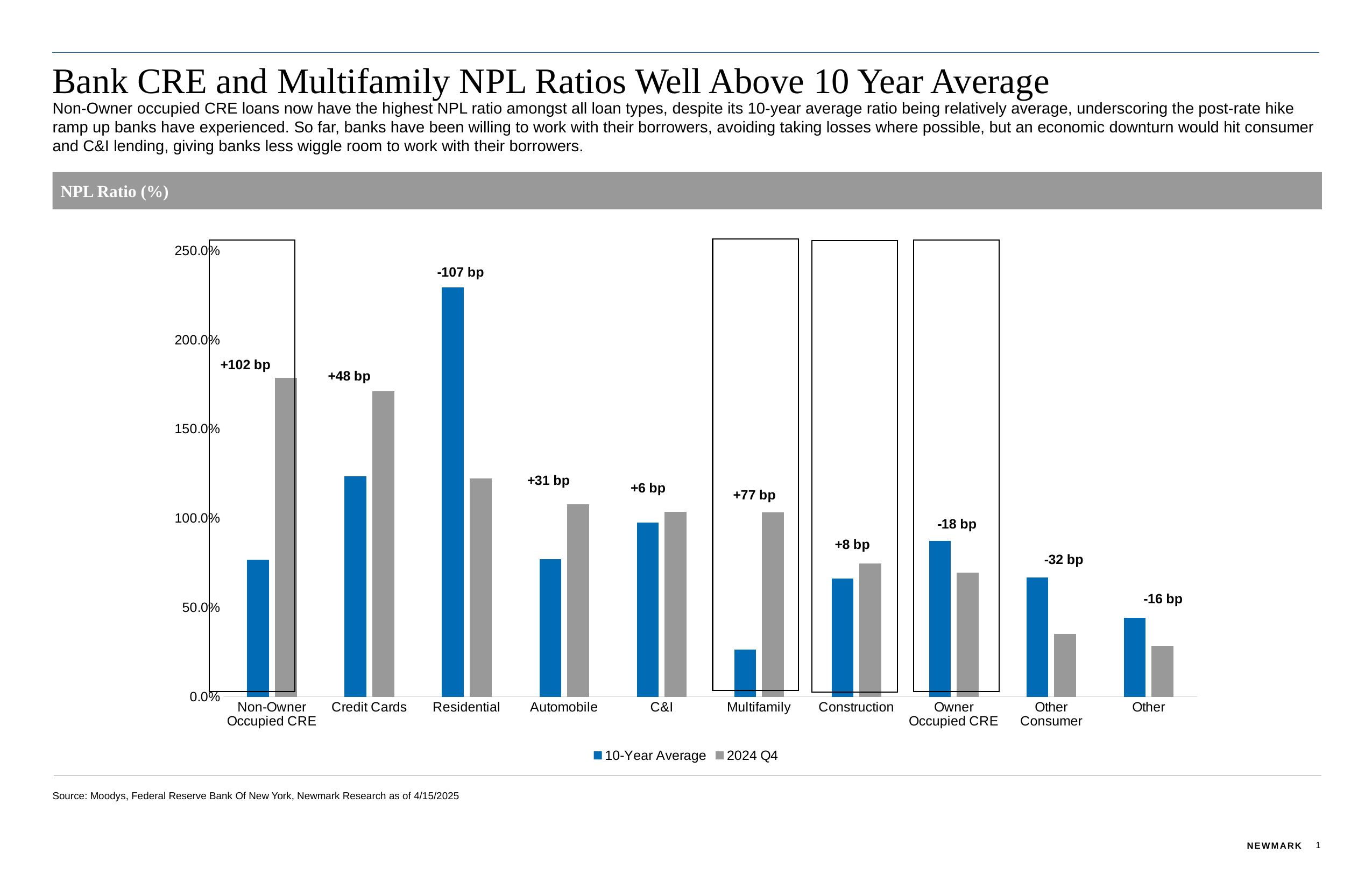
What basis-point change is labelled above the Non-Owner Occupied CRE bars? +102 bp What are the two series named in the chart's legend? 10-Year Average and 2024 Q4 Which category has the lowest 10-Year Average NPL ratio? Multifamily How many series does the chart's legend list? 2 Is the 10-Year Average value for Residential greater or less than 200.0%? greater What is the title shown in the grey bar above the chart? NPL Ratio (%) What basis-point change is labelled above the Multifamily bars? +77 bp For Multifamily, which is larger: the 10-Year Average or the 2024 Q4 value? 2024 Q4 How many loan categories are shown on the x axis of the chart? 10 What kind of chart is shown on the slide? bar chart What basis-point change is labelled above the Residential bars? -107 bp Which category has the highest 10-Year Average NPL ratio? Residential